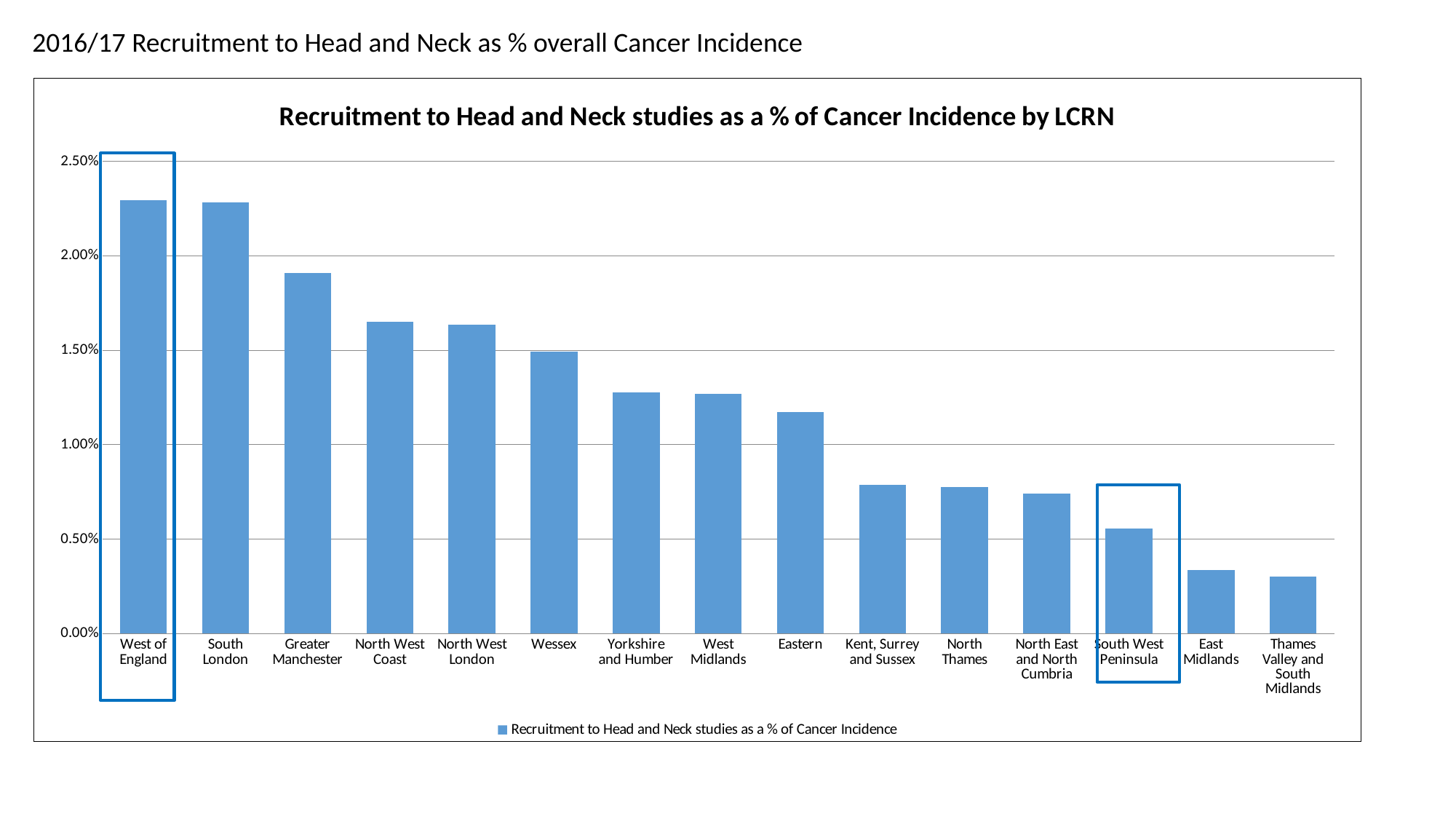
Is the value for East Midlands greater or less than 0.50%? less How many LCRN categories are plotted on the x axis? 15 Is the value for Greater Manchester greater or less than 1.50%? greater Which has the larger value, Greater Manchester or Wessex? Greater Manchester Which has the larger value, Eastern or South West Peninsula? Eastern Is the value for South West Peninsula greater or less than 0.50%? greater How many series does the legend list? 1 What kind of chart is shown on the slide? Bar chart What is the title of the chart? Recruitment to Head and Neck studies as a % of Cancer Incidence by LCRN Do the values rise or fall moving from left to right along the x axis? Fall